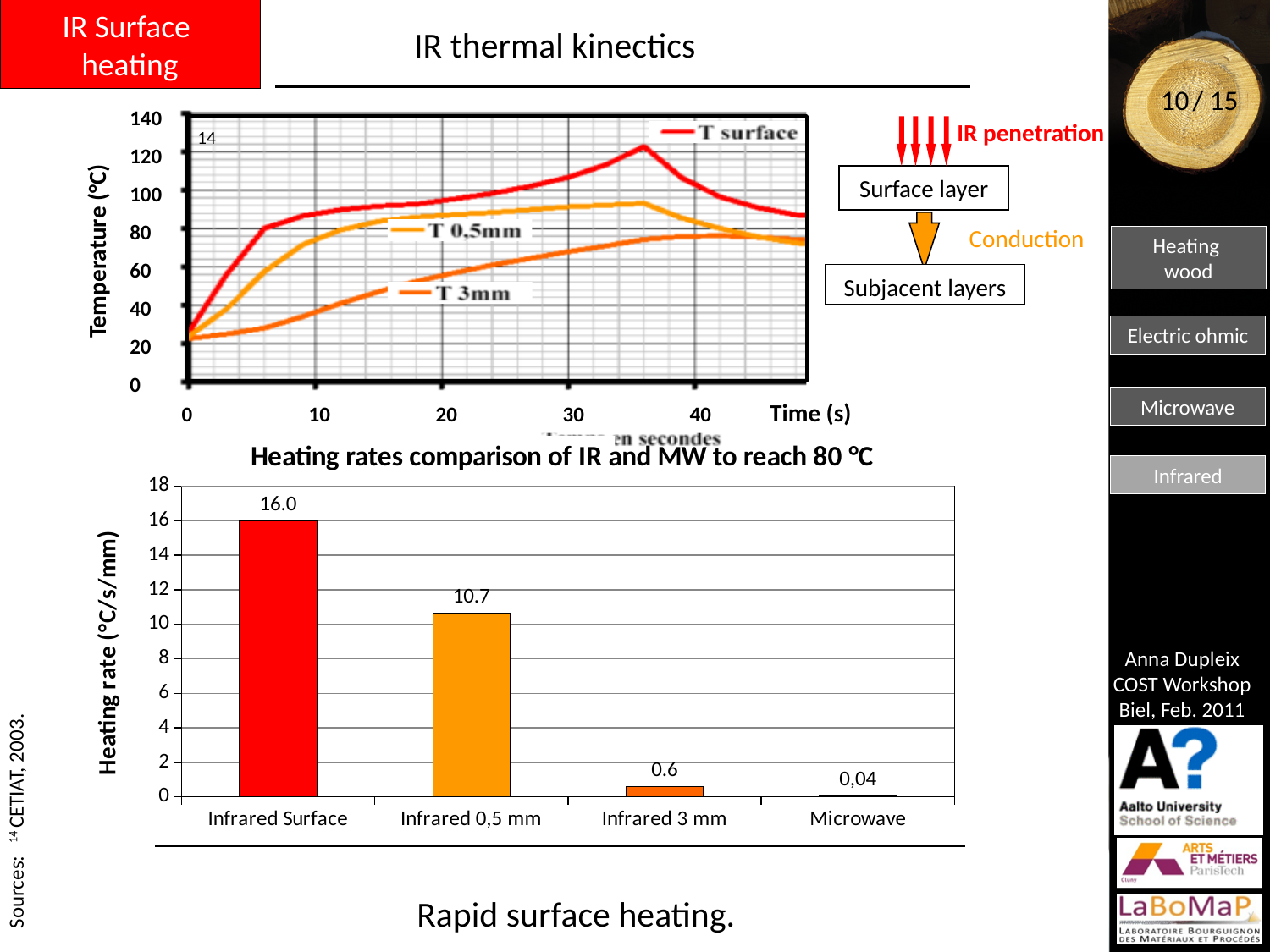
In the bar chart 'Heating rates comparison of IR and MW to reach 80 °C', which is larger, the heating rate for Infrared 3 mm or for Microwave? Infrared 3 mm In the bar chart 'Heating rates comparison of IR and MW to reach 80 °C', which category has the lowest heating rate? Microwave In the bar chart 'Heating rates comparison of IR and MW to reach 80 °C', what is the heating rate for Infrared Surface? 16.0 In the top chart 'IR thermal kinetics', how many series are labelled in the plot? 3 In the bar chart 'Heating rates comparison of IR and MW to reach 80 °C', which category has the highest heating rate? Infrared Surface In the bar chart 'Heating rates comparison of IR and MW to reach 80 °C', what is the heating rate for Microwave? 0,04 In the bar chart 'Heating rates comparison of IR and MW to reach 80 °C', what is the heating rate for Infrared 0,5 mm? 10.7 In the bar chart 'Heating rates comparison of IR and MW to reach 80 °C', what is the heating rate for Infrared 3 mm? 0.6 What kind of chart is the bottom chart 'Heating rates comparison of IR and MW to reach 80 °C'? Bar chart In the bar chart 'Heating rates comparison of IR and MW to reach 80 °C', what is the difference between the heating rates of Infrared Surface and Infrared 0,5 mm? 5.3 In the bar chart 'Heating rates comparison of IR and MW to reach 80 °C', how many categories are shown on the x axis? 4 In the top chart 'IR thermal kinetics', what is the label of the y axis? Temperature (°C)